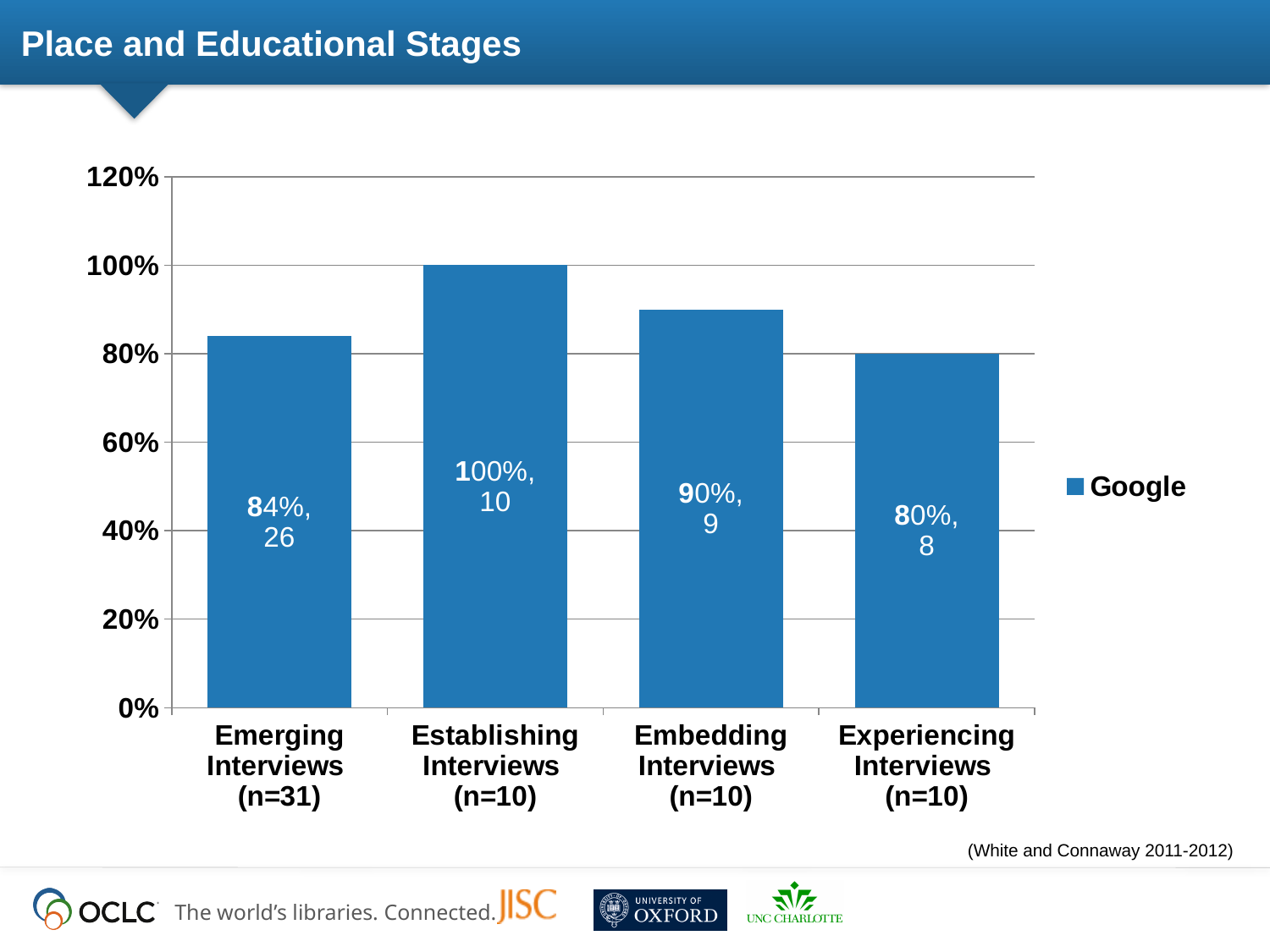
What percentage is shown for Emerging Interviews (n=31)? 84% Which is larger, the percentage for Emerging Interviews or for Embedding Interviews? Embedding Interviews Which educational stage has the lowest percentage? Experiencing Interviews What percentage is shown for Establishing Interviews (n=10)? 100% What is the difference in percentage points between Establishing Interviews and Experiencing Interviews? 20 Is the value for Emerging Interviews greater or less than 80%? greater What series name does the legend show? Google Which educational stage has the highest percentage? Establishing Interviews What kind of chart is shown on the slide? bar chart How many interviews are counted in the data label for Embedding Interviews? 9 How many educational stages are shown on the x axis? 4 What percentage is shown for Experiencing Interviews (n=10)? 80%